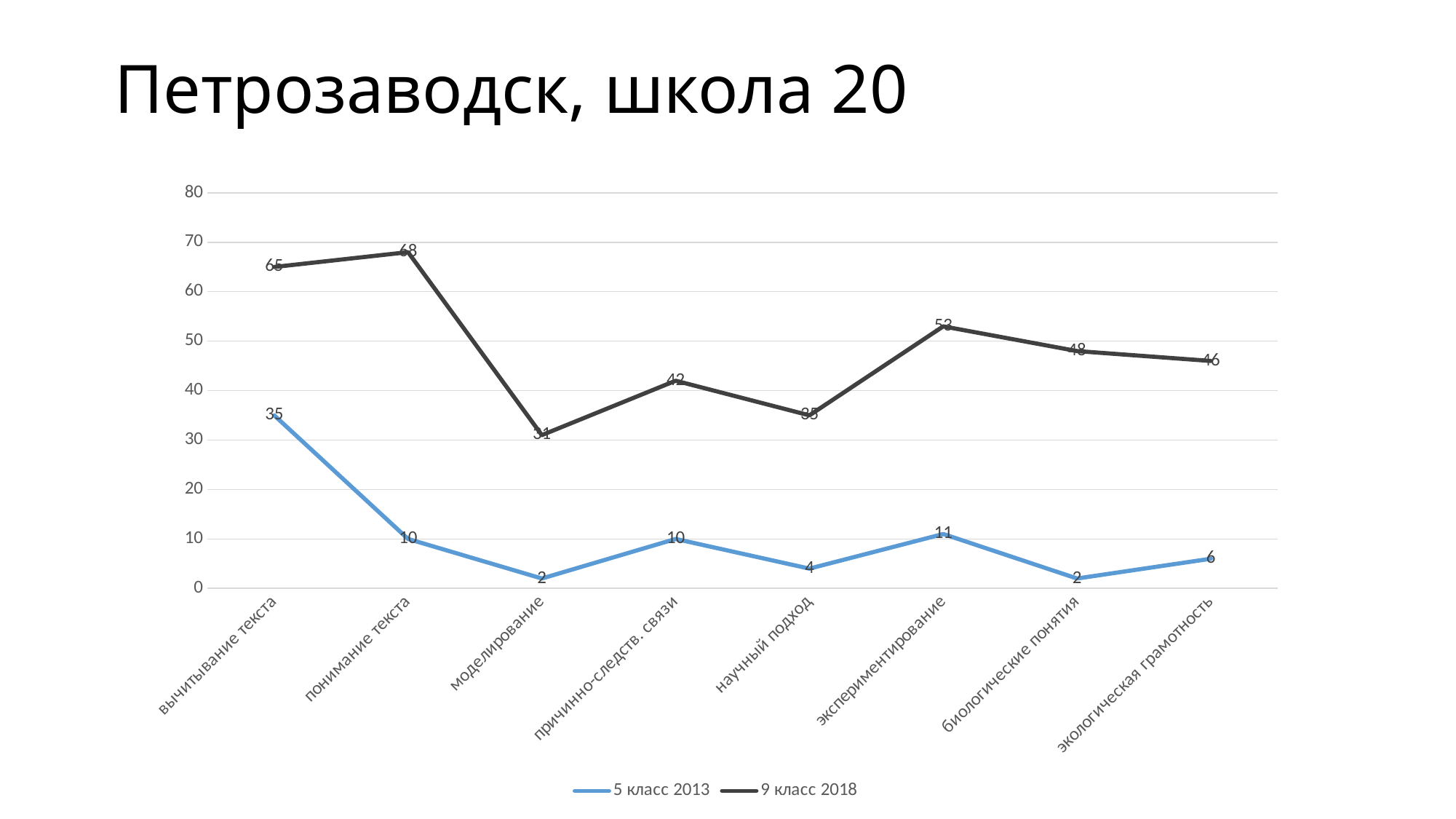
Which category has the highest value in the '5 класс 2013' series? вычитывание текста What is the value for 'экологическая грамотность' in the '9 класс 2018' series? 46 What is the title of the slide? Петрозаводск, школа 20 What is the difference between the '9 класс 2018' and '5 класс 2013' values for 'экспериментирование'? 42 How many categories are shown on the x axis? 8 Which is larger: the '9 класс 2018' value for 'научный подход' or for 'причинно-следств. связи'? причинно-следств. связи What is the value for 'понимание текста' in the '9 класс 2018' series? 68 How many series does the legend list? 2 What type of chart is shown on the slide? line chart Which category has the lowest value in the '9 класс 2018' series? моделирование What is the value for 'вычитывание текста' in the '5 класс 2013' series? 35 Which category has the highest value in the '9 класс 2018' series? понимание текста